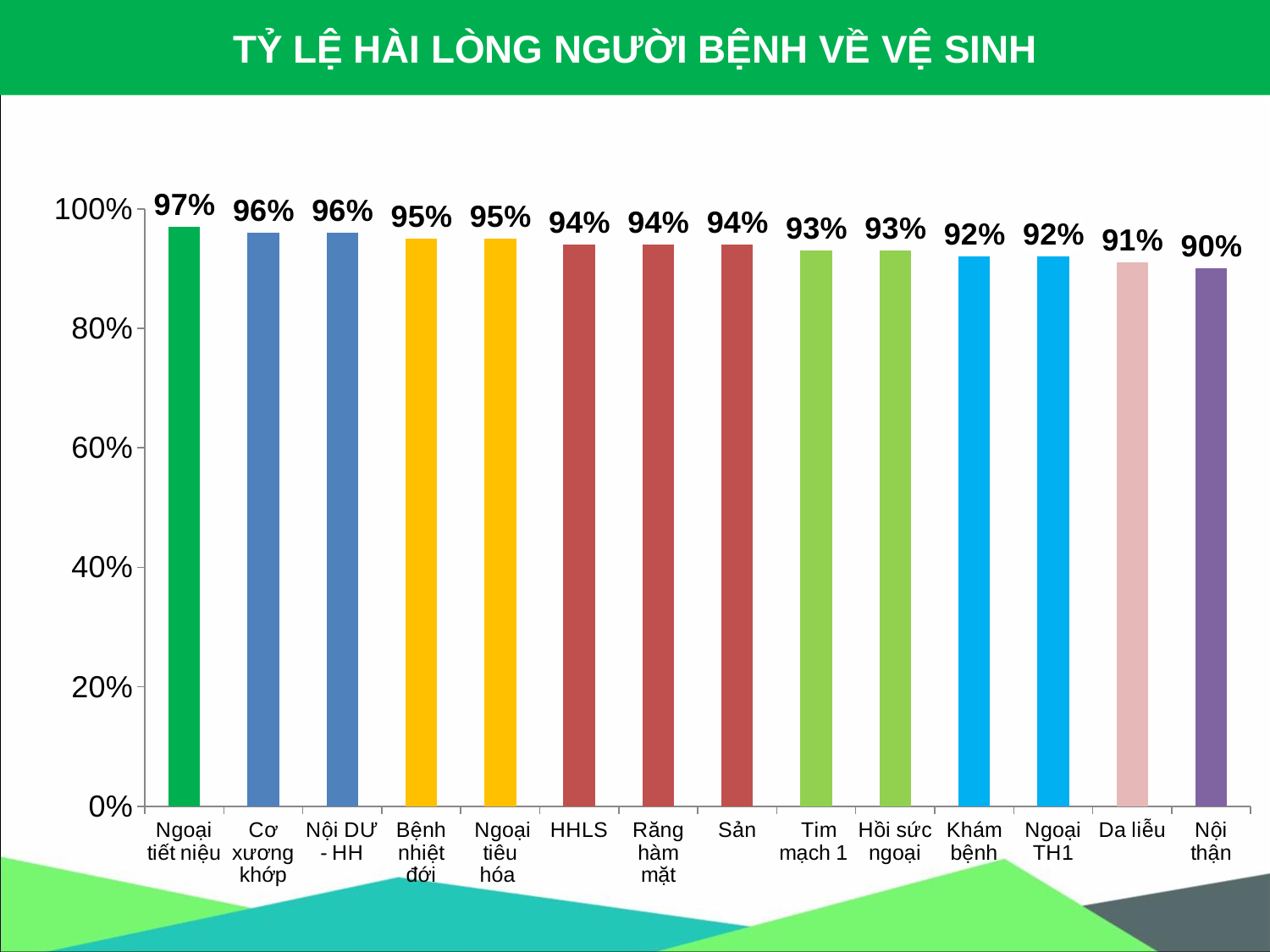
What is the value shown for Da liễu? 91% Which has a higher value, Sản or Khám bệnh? Sản What is the difference between the values for Ngoại tiết niệu and Nội thận? 7% Which department has the highest satisfaction rate? Ngoại tiết niệu What is the value shown for Nội thận? 90% Which department has the lowest satisfaction rate? Nội thận What is the difference between the values for Cơ xương khớp and Da liễu? 5% What is the value shown for HHLS? 94% Do the values rise or fall from left to right along the x axis? Fall How many departments are shown in the chart? 14 What is the satisfaction rate for Ngoại tiết niệu? 97% What type of chart is shown on the slide? Bar chart